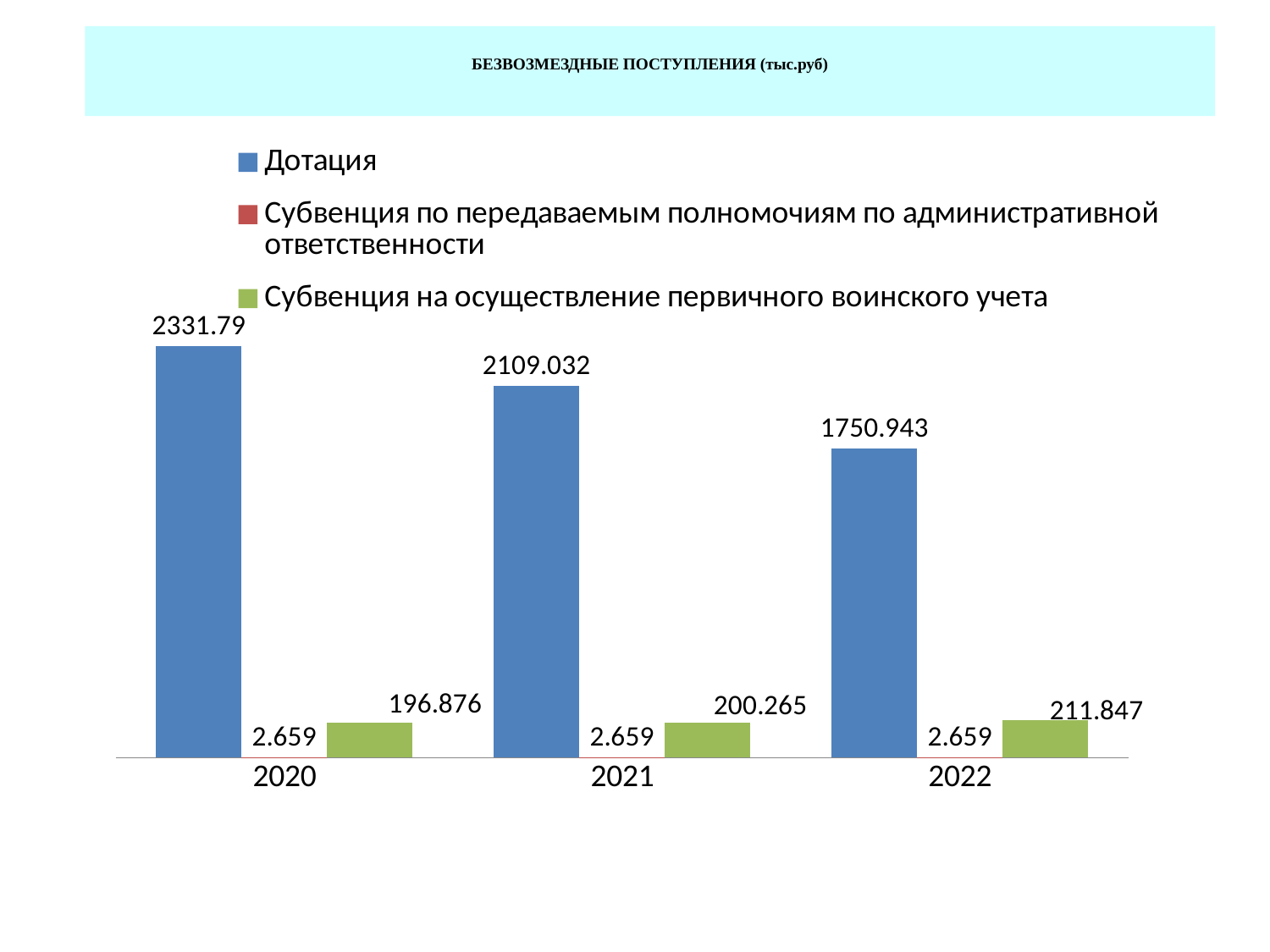
What is the value of Дотация for 2020? 2331.79 What is the value of Дотация for 2022? 1750.943 What is the value of Субвенция по передаваемым полномочиям по административной ответственности for 2022? 2.659 Which is larger: Субвенция на осуществление первичного воинского учета in 2022 or in 2021? 2022 What is the value of Субвенция на осуществление первичного воинского учета for 2021? 200.265 How many series does the legend list? 3 In which year is Субвенция на осуществление первичного воинского учета lowest? 2020 How many years are shown on the x axis? 3 What kind of chart is shown on the slide? Bar chart Does Дотация rise or fall from 2020 to 2022? Fall What is the difference between Дотация in 2020 and Дотация in 2021? 222.758 In which year is Дотация highest? 2020